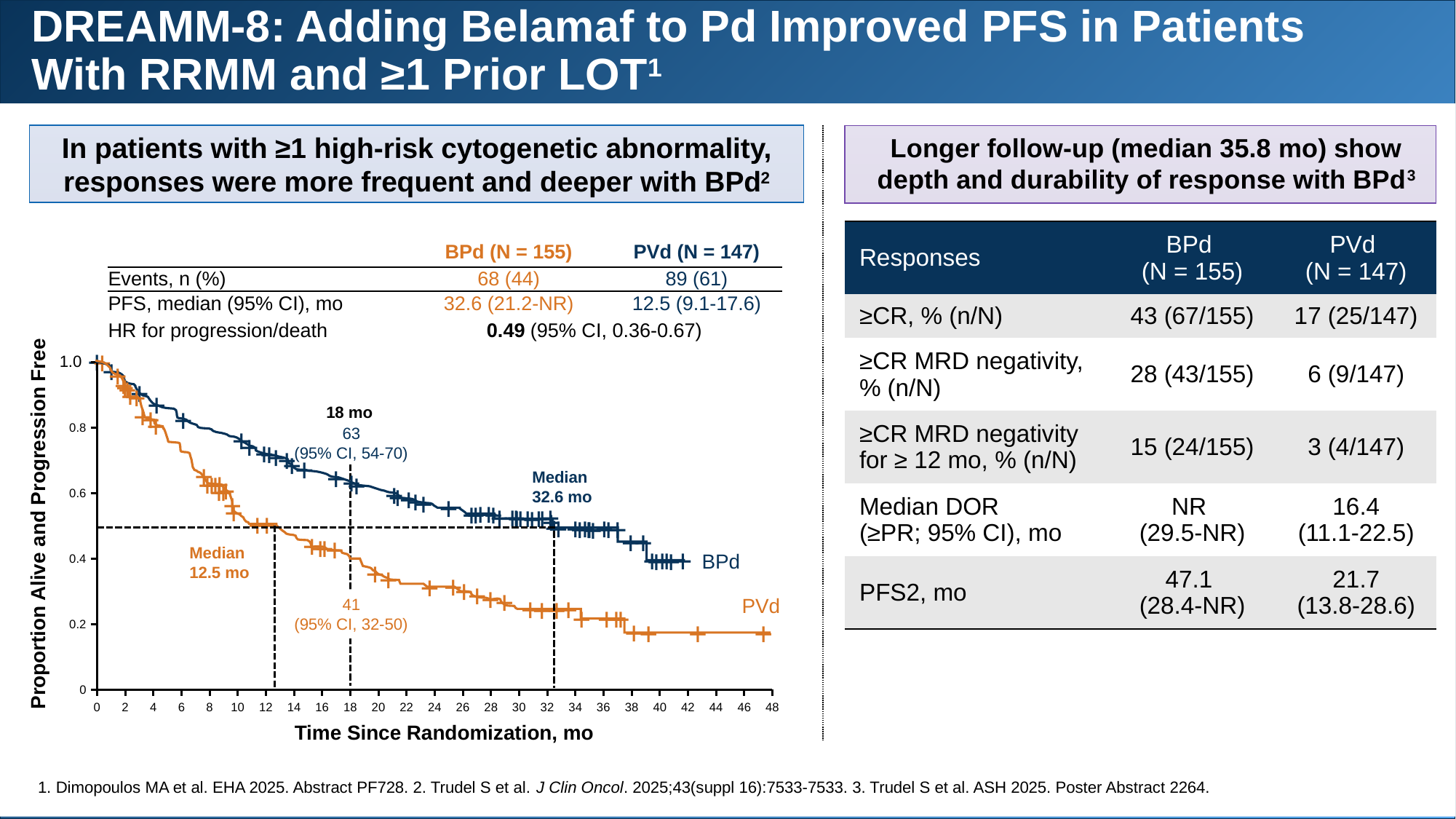
What is the label of the x axis of the chart? Time Since Randomization, mo What is the 18-month PFS rate labelled for the BPd curve? 63 What is the 18-month PFS rate labelled for the PVd curve? 41 Which arm has the higher proportion alive and progression free at 18 months, BPd or PVd? BPd What is the median PFS for the BPd arm shown on the chart? 32.6 mo What is the difference between the 18-month PFS rates of BPd and PVd? 22 What kind of chart is shown on the left of the slide? Line chart (Kaplan-Meier curve) Do the curves rise or fall as time since randomization increases? Fall How many treatment arms (curves) are plotted in the chart? 2 What is the median PFS for the PVd arm shown on the chart? 12.5 mo Is the proportion alive and progression free for PVd at 30 months greater or less than 0.4? less By how many months does the median PFS of BPd exceed that of PVd? 20.1 mo